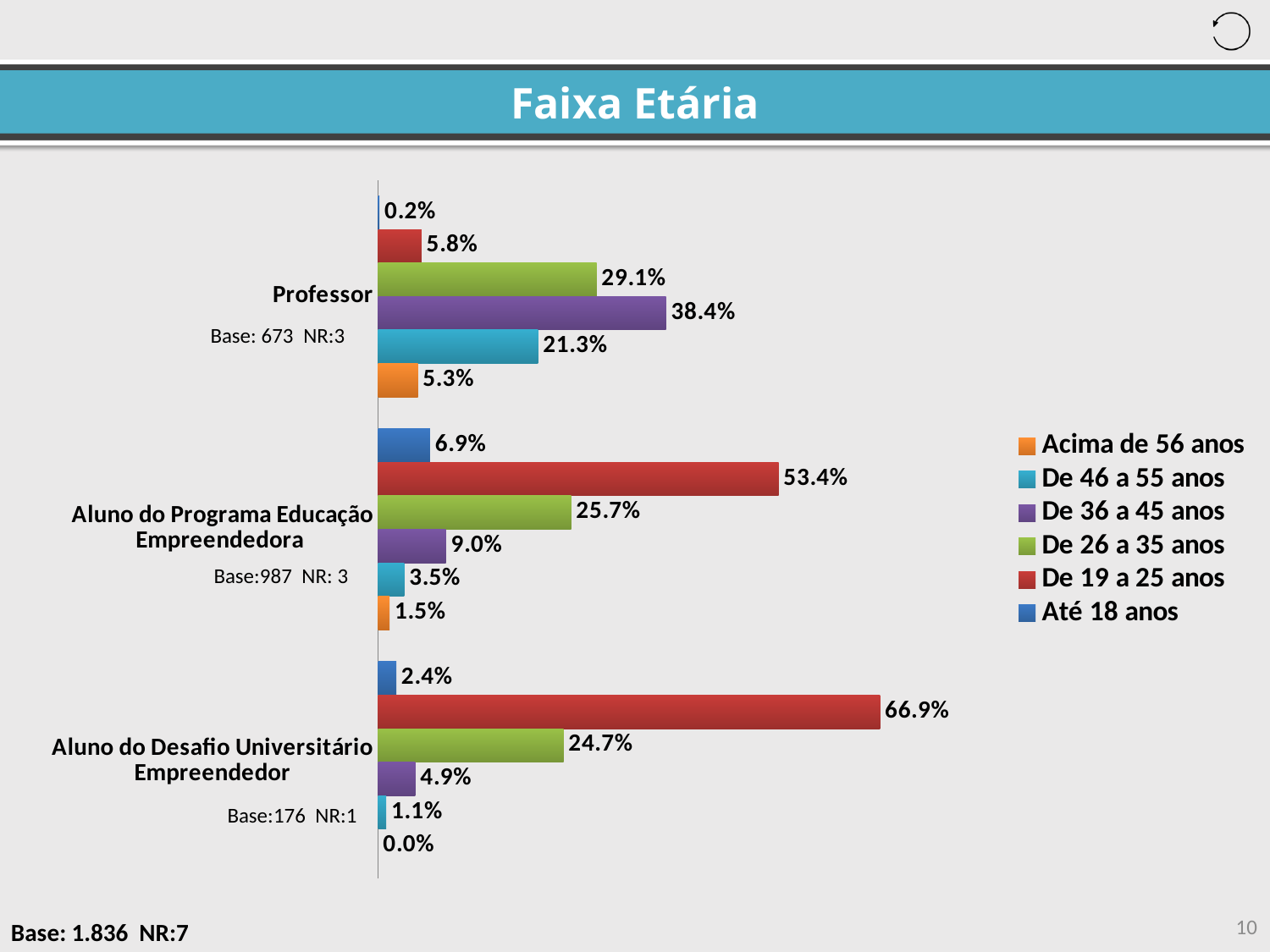
What is the title of the slide? Faixa Etária Which is larger: the 'De 26 a 35 anos' value for Professor or for 'Aluno do Programa Educação Empreendedora'? Professor What percentage of Professor respondents are in the 'De 36 a 45 anos' age range? 38.4% What is the base and NR shown for the Professor group? Base: 673 NR:3 Which age range has the highest value in the 'Aluno do Programa Educação Empreendedora' group? De 19 a 25 anos What is the difference between the 'De 19 a 25 anos' values for 'Aluno do Desafio Universitário Empreendedor' and 'Aluno do Programa Educação Empreendedora'? 13.5% What is the value for 'De 19 a 25 anos' in the 'Aluno do Desafio Universitário Empreendedor' group? 66.9% Which age range has the lowest value in the Professor group? Até 18 anos How many respondent groups (categories) are shown on the chart? 3 What is the value for 'Acima de 56 anos' in the 'Aluno do Programa Educação Empreendedora' group? 1.5% How many age ranges does the legend list? 6 What type of chart is shown on the slide? Bar chart